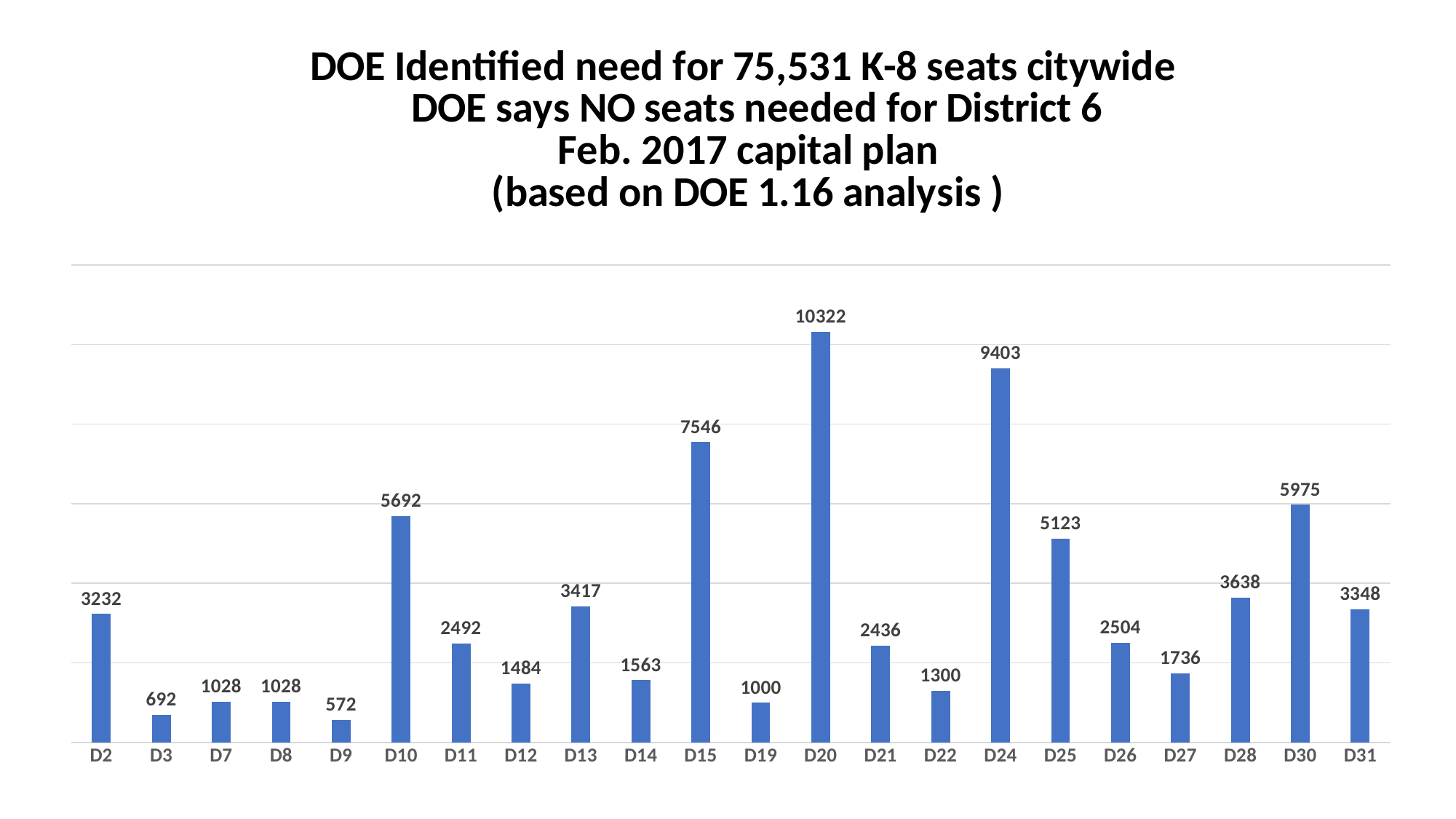
What kind of chart is shown on the slide? Bar chart What is the value for D20? 10322 What is the difference between the values for D30 and D10? 283 What is the difference between the values for D20 and D24? 919 Which district has the lowest value? D9 Which two districts share the same value of 1028? D7 and D8 Which is larger, the value for D25 or the value for D30? D30 What is the value for D15? 7546 What is the value for D28? 3638 What is the value for D9? 572 How many districts are shown on the x axis? 22 Which district has the highest value? D20